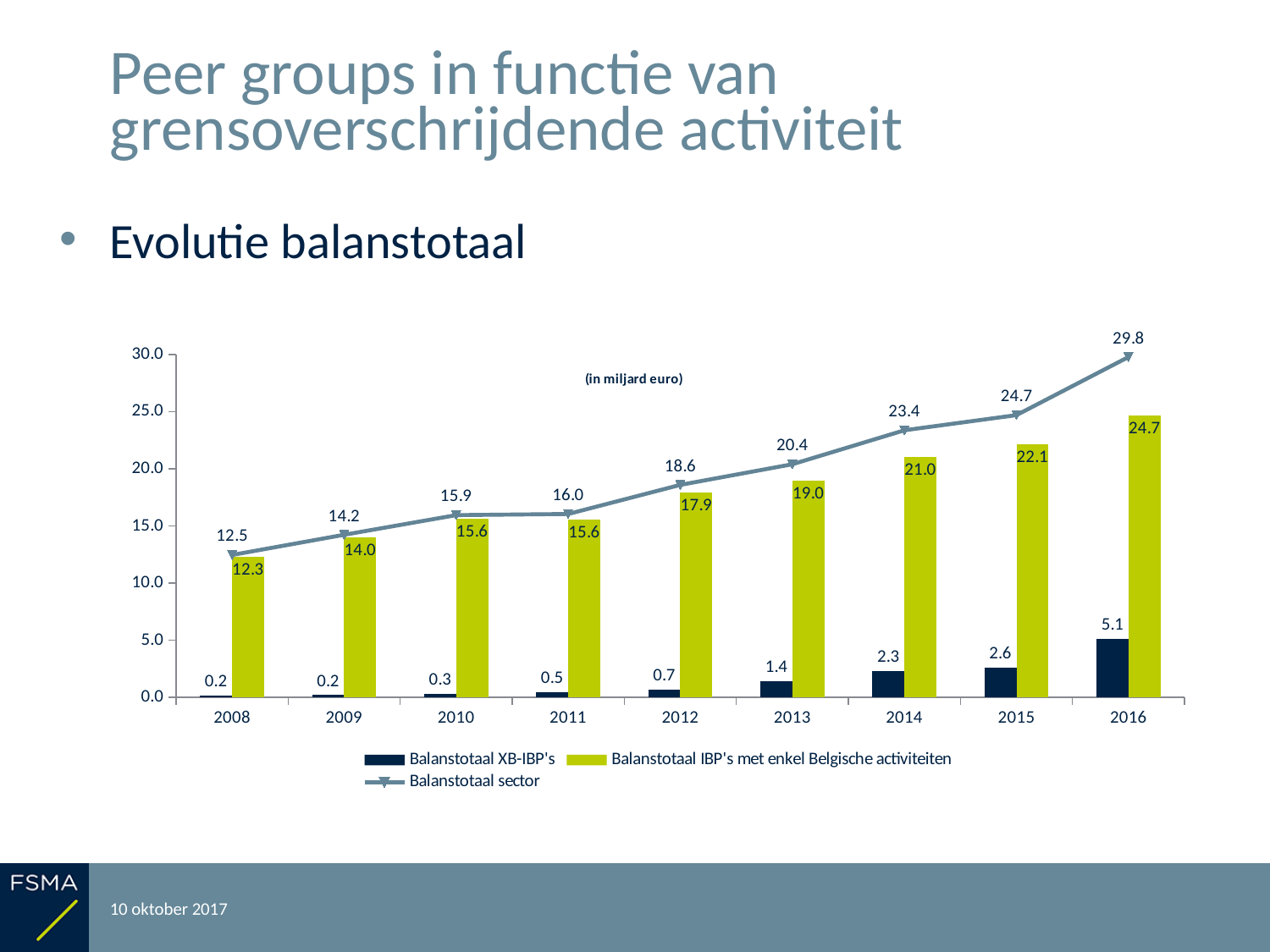
What is the value of Balanstotaal XB-IBP's in 2015? 2.6 In which year is Balanstotaal sector lowest? 2008 How many series does the legend list? 3 What is the value of Balanstotaal IBP's met enkel Belgische activiteiten in 2013? 19.0 Which is larger: Balanstotaal IBP's met enkel Belgische activiteiten in 2012 or in 2014? 2014 Does Balanstotaal sector rise or fall from 2008 to 2016? rise In which year is Balanstotaal XB-IBP's highest? 2016 What unit is stated inside the chart area? in miljard euro Is the value of Balanstotaal IBP's met enkel Belgische activiteiten in 2010 greater or less than 15.0? greater How many years are shown on the x axis? 9 What is the value of Balanstotaal sector in 2016? 29.8 What is the difference between Balanstotaal sector in 2016 and in 2015? 5.1